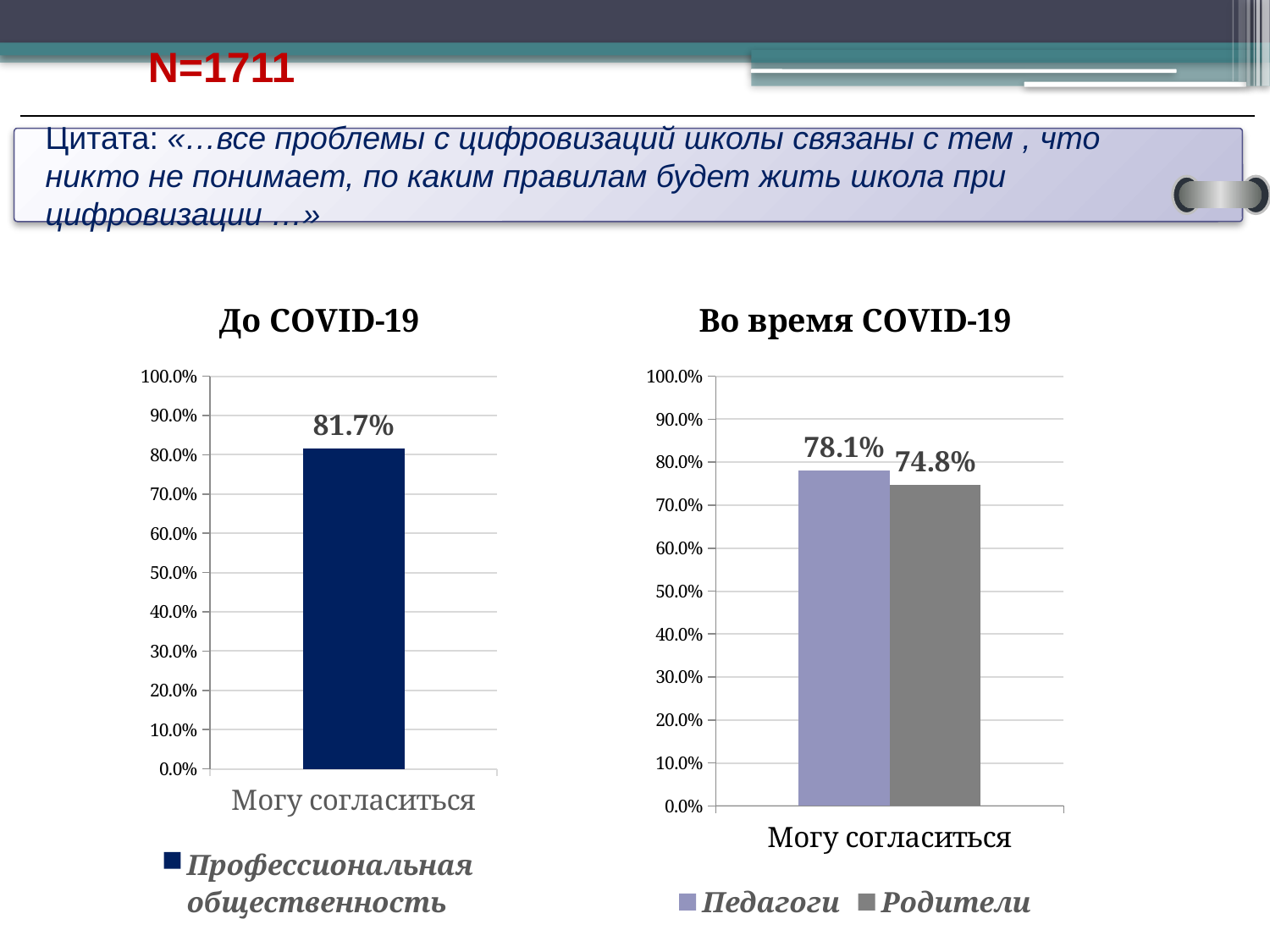
What is the difference between the 'Профессиональная общественность' value in the 'До COVID-19' chart and the 'Педагоги' value in the 'Во время COVID-19' chart? 3.6% In the 'Во время COVID-19' chart, what is the value for 'Педагоги'? 78.1% How many series does the legend of the 'Во время COVID-19' chart list? 2 What is the category label on the x axis of the 'Во время COVID-19' chart? Могу согласиться In the 'До COVID-19' chart, is the value for 'Профессиональная общественность' greater or less than 80%? greater In the 'Во время COVID-19' chart, what is the difference between the values for 'Педагоги' and 'Родители'? 3.3% In the 'Во время COVID-19' chart, what is the value for 'Родители'? 74.8% In the 'До COVID-19' chart, what is the value for 'Профессиональная общественность' for 'Могу согласиться'? 81.7% What kind of chart is the 'До COVID-19' chart? Bar chart In the 'Во время COVID-19' chart, which series has the higher value: 'Педагоги' or 'Родители'? Педагоги How many series does the legend of the 'До COVID-19' chart list? 1 What is the title of the chart on the right side of the slide? Во время COVID-19